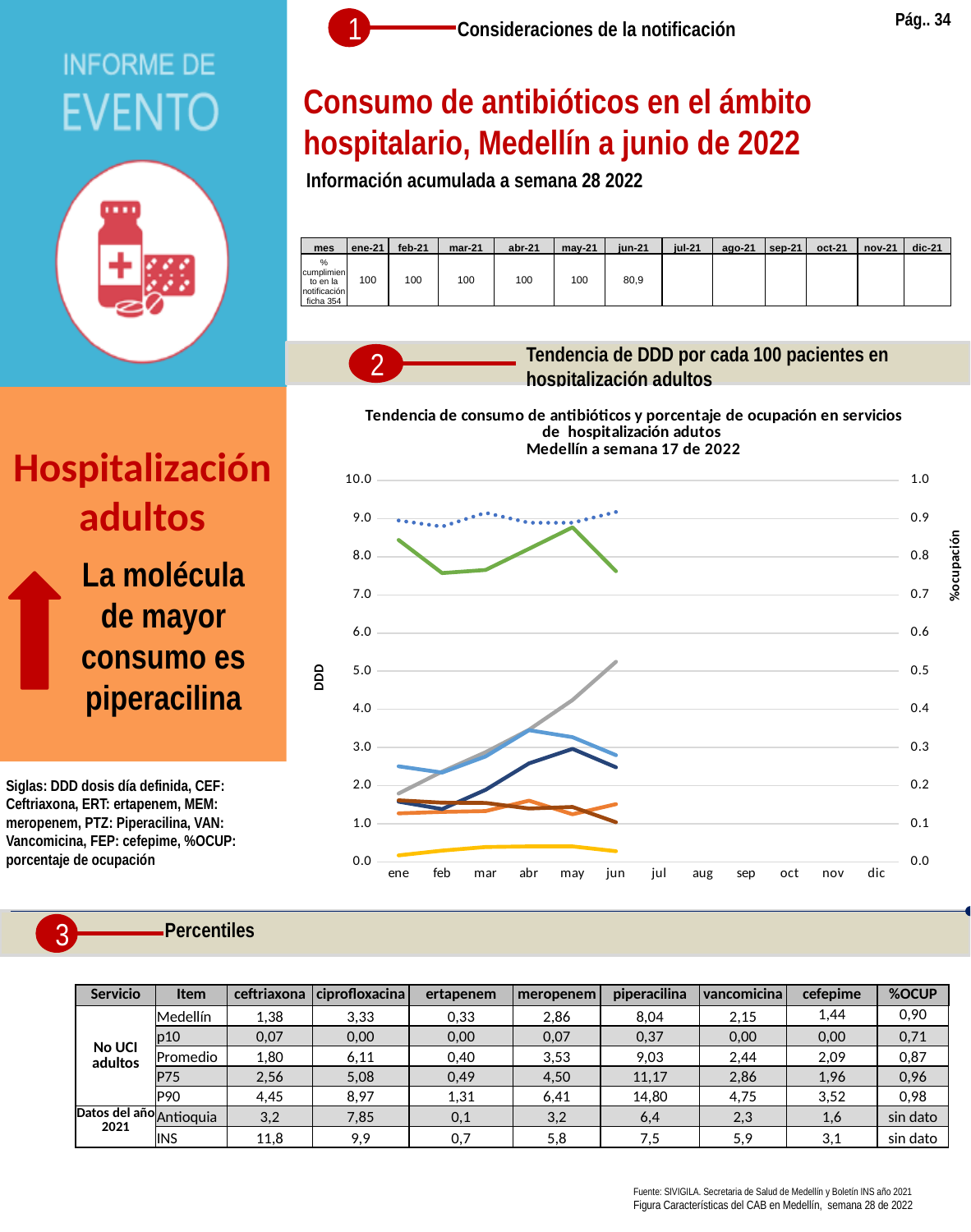
In the line chart, is the value of the green line in ene greater or less than 8.0 on the DDD axis? greater In the line chart, is the value of the green line in feb greater or less than 8.0 on the DDD axis? less In the line chart, is the value of the grey line in jun greater or less than 4.0 on the DDD axis? greater What is the label of the left vertical axis of the line chart? DDD What kind of chart is shown under the heading 'Tendencia de DDD por cada 100 pacientes en hospitalización adultos'? Line chart What is the title of the line chart on the slide? Tendencia de consumo de antibióticos y porcentaje de ocupación en servicios de hospitalización adutos Medellín a semana 17 de 2022 In the line chart, does the grey line rise or fall from ene to jun? Rise How many month categories are shown on the x axis of the line chart? 12 What is the maximum value shown on the left vertical axis of the line chart? 10.0 What is the maximum value shown on the right vertical axis (%ocupación) of the line chart? 1.0 Up to which month do the lines in the line chart have plotted data? jun